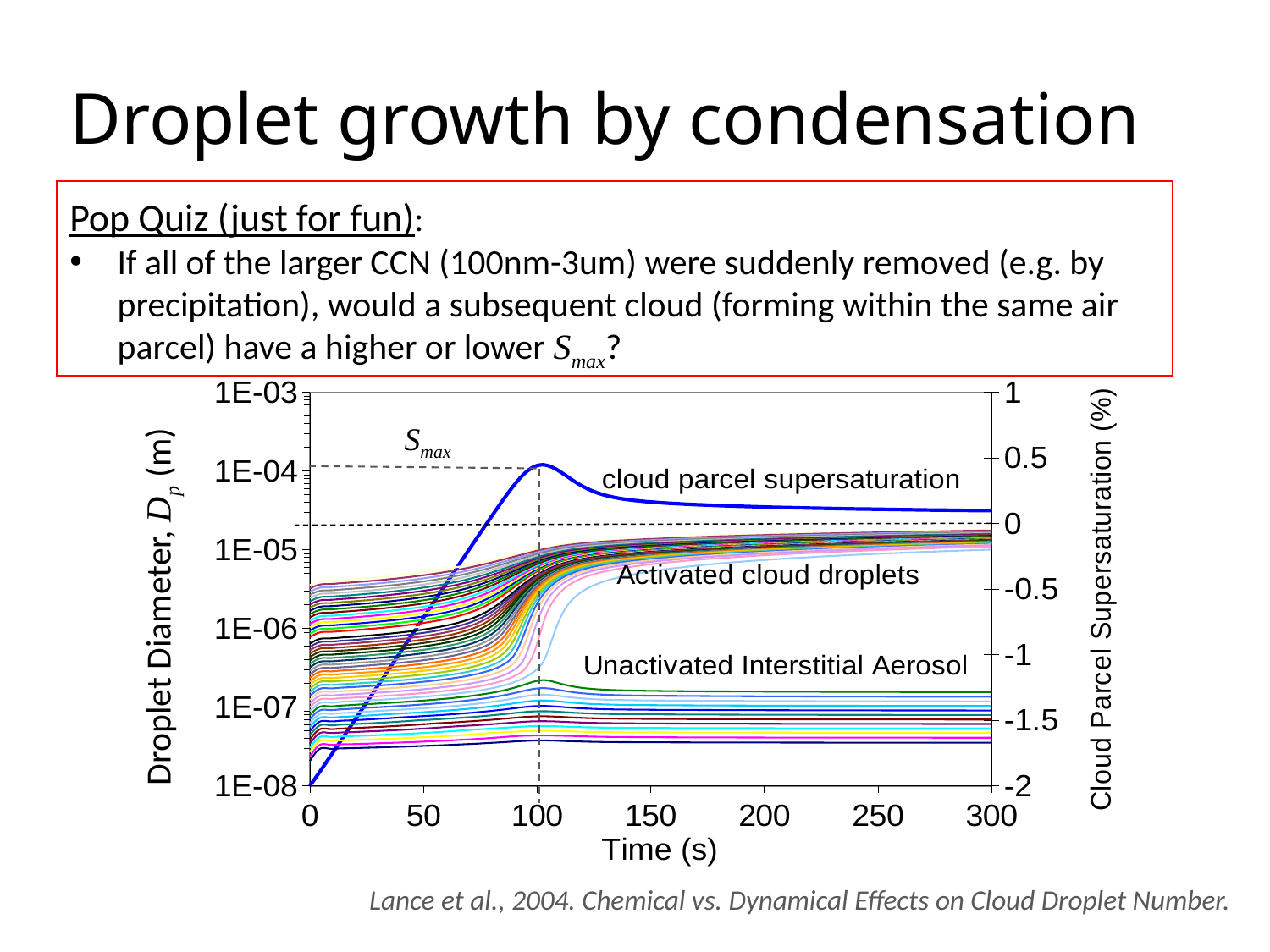
At 300 s, are the diameters of the activated cloud droplets greater or less than 1E-06 m? greater At 300 s, are the diameters of the unactivated interstitial aerosol greater or less than 1E-06 m? less At what time (s) does the cloud parcel supersaturation reach its maximum, S_max, according to the dashed vertical line? 100 At 300 s, which group of lines has larger droplet diameters: the activated cloud droplets or the unactivated interstitial aerosol? Activated cloud droplets What is the cloud parcel supersaturation (%) at time 0 s? -2 What is the label of the x axis of the chart? Time (s) What is the label of the right-hand y axis of the chart? Cloud Parcel Supersaturation (%) Is the peak cloud parcel supersaturation (S_max) greater or less than 0%? greater Does the cloud parcel supersaturation rise or fall between 0 s and 100 s? rise What kind of chart is shown on the slide? line chart Does the cloud parcel supersaturation rise or fall between 100 s and 300 s? fall